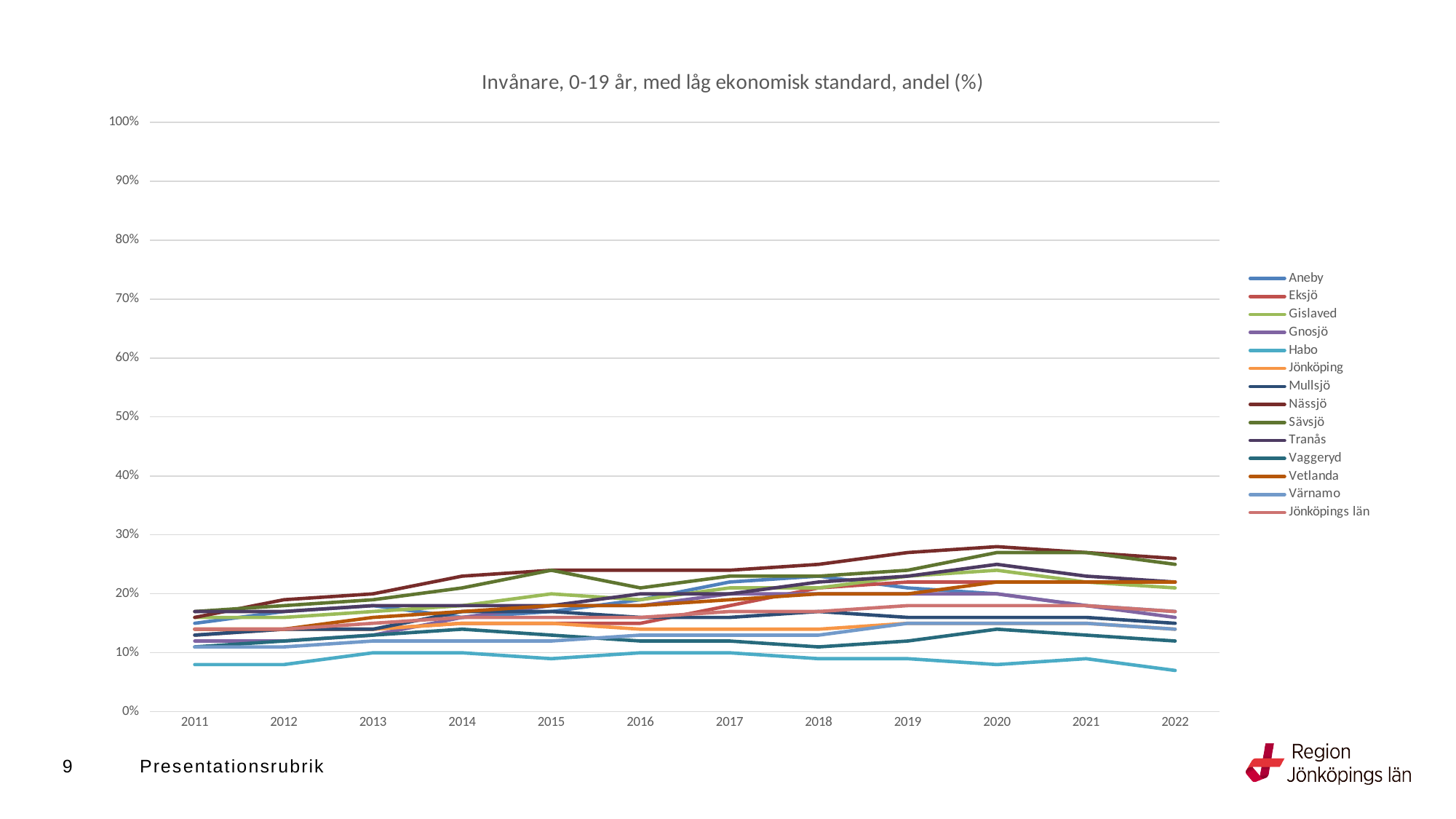
Is the value for Nässjö in 2020 greater or less than 20%? greater What kind of chart is shown on the slide? line chart Which is larger in 2020, the value for Nässjö or the value for Habo? Nässjö Which series has the highest value in 2020? Nässjö How many years are shown on the x axis? 12 Which series has the lowest value in 2022? Habo Is the value for Habo in 2022 greater or less than 10%? less Is the value for Jönköpings län in 2022 greater or less than 20%? less Does the value for Nässjö rise or fall from 2011 to 2020? rise How many series does the legend list? 14 What is the title of the chart? Invånare, 0-19 år, med låg ekonomisk standard, andel (%)